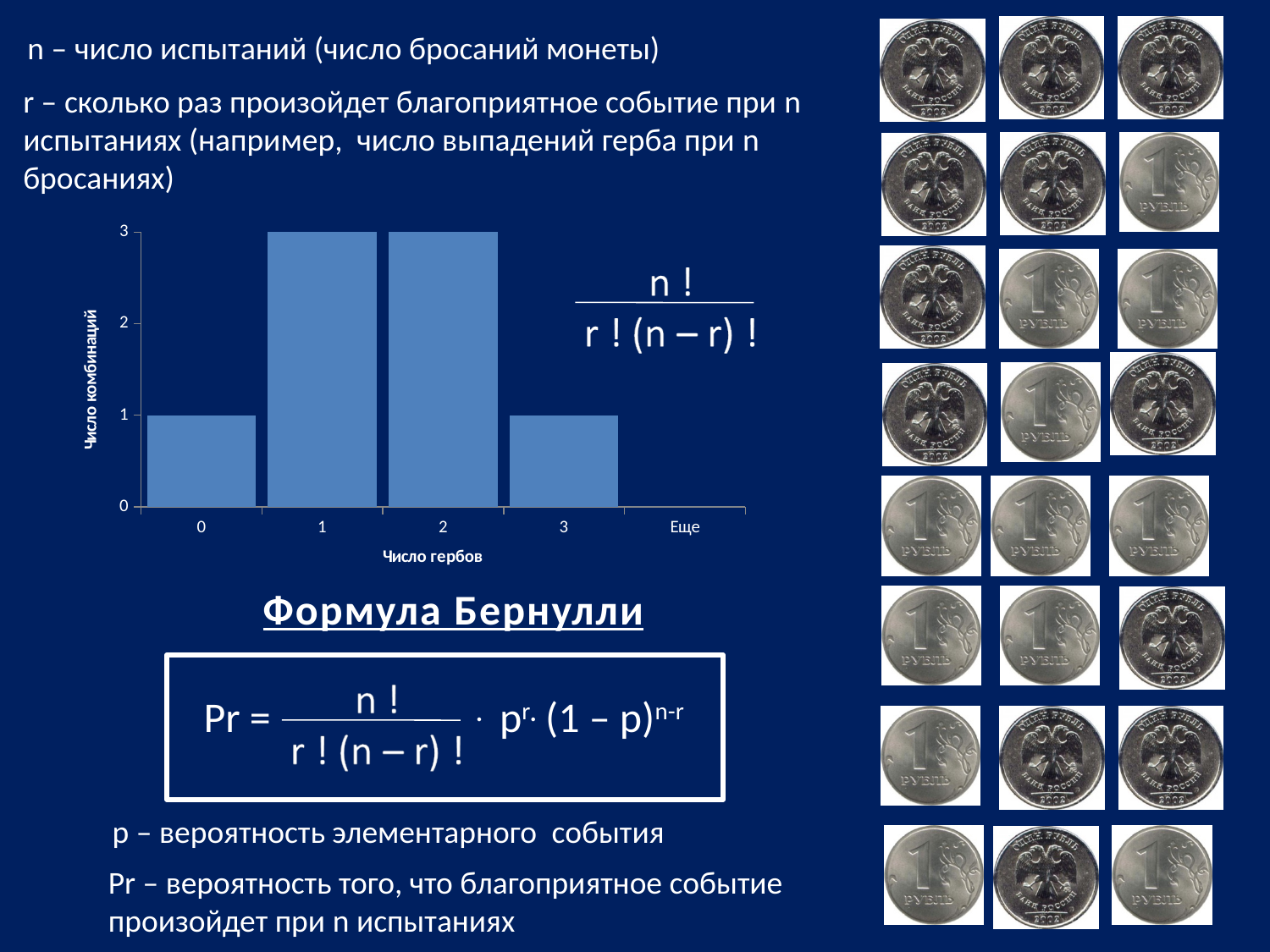
Which has the larger value, category 1 or category 0? 1 What is the value (Число комбинаций) for the category 3 on the x axis? 1 How many bars are plotted in the chart? 4 Which has the larger value, category 2 or category 3? 2 What is the title of the x axis of the chart? Число гербов What is the value (Число комбинаций) for the category 2 on the x axis? 3 What is the title of the y axis of the chart? Число комбинаций What is the value (Число комбинаций) for the category 0 on the x axis? 1 What is the difference between the values for category 1 and category 0? 2 Is the value for category 2 greater or less than 2? greater What type of chart is shown on the slide? bar chart What is the value (Число комбинаций) for the category 1 on the x axis? 3